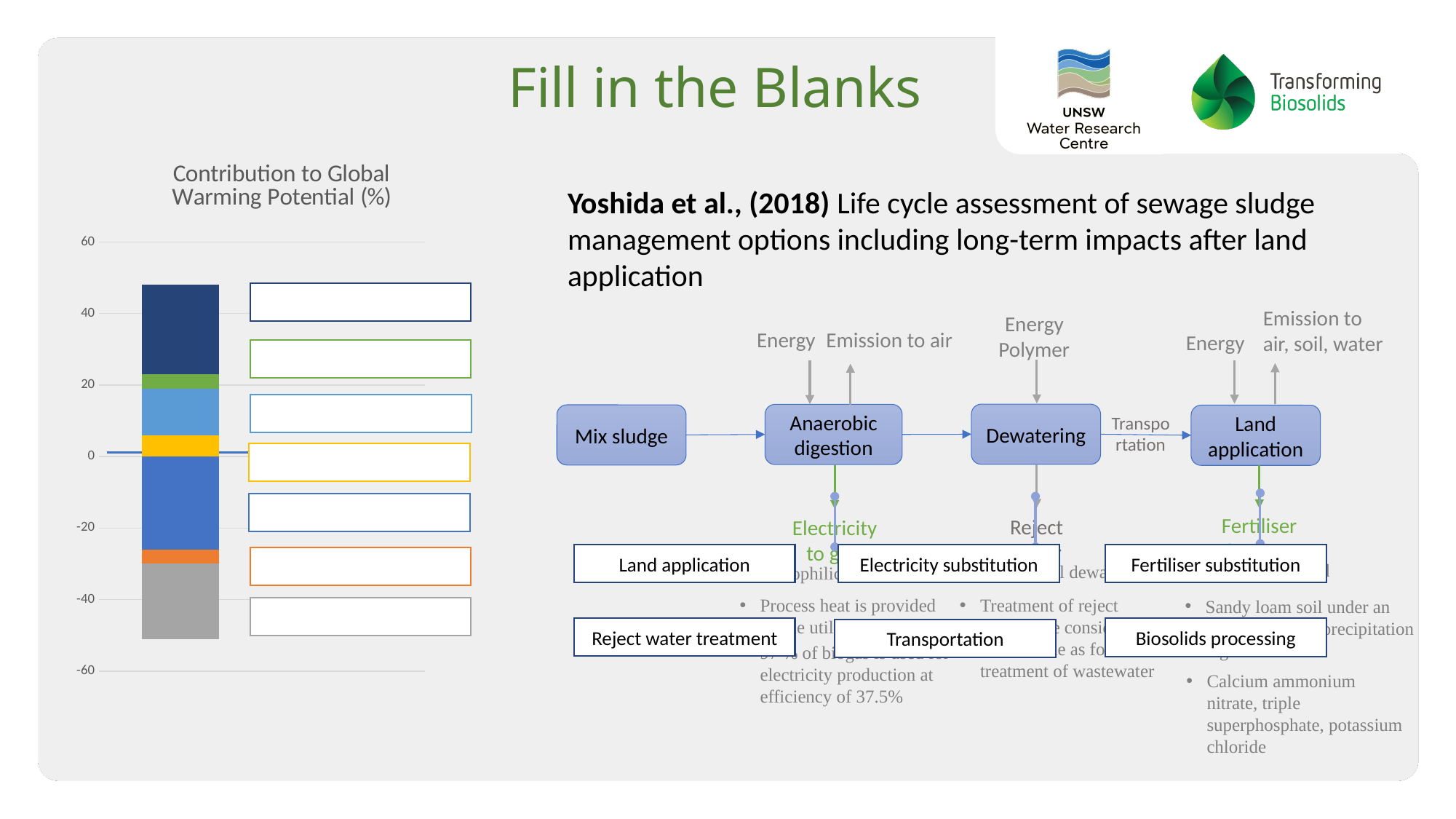
What is the highest value shown on the chart's vertical axis? 60 Is the bottom of the grey segment at the bottom of the stacked bar greater or less than -40? less How many bars does the chart contain? 1 What kind of chart is shown on the left of the slide? Stacked bar chart How many coloured segments make up the stacked bar in the chart? 7 Is the top of the dark blue segment at the top of the stacked bar greater or less than 40? greater What is the title of the chart on the left of the slide? Contribution to Global Warming Potential (%) Is the bottom of the medium blue segment below zero greater or less than -20? less